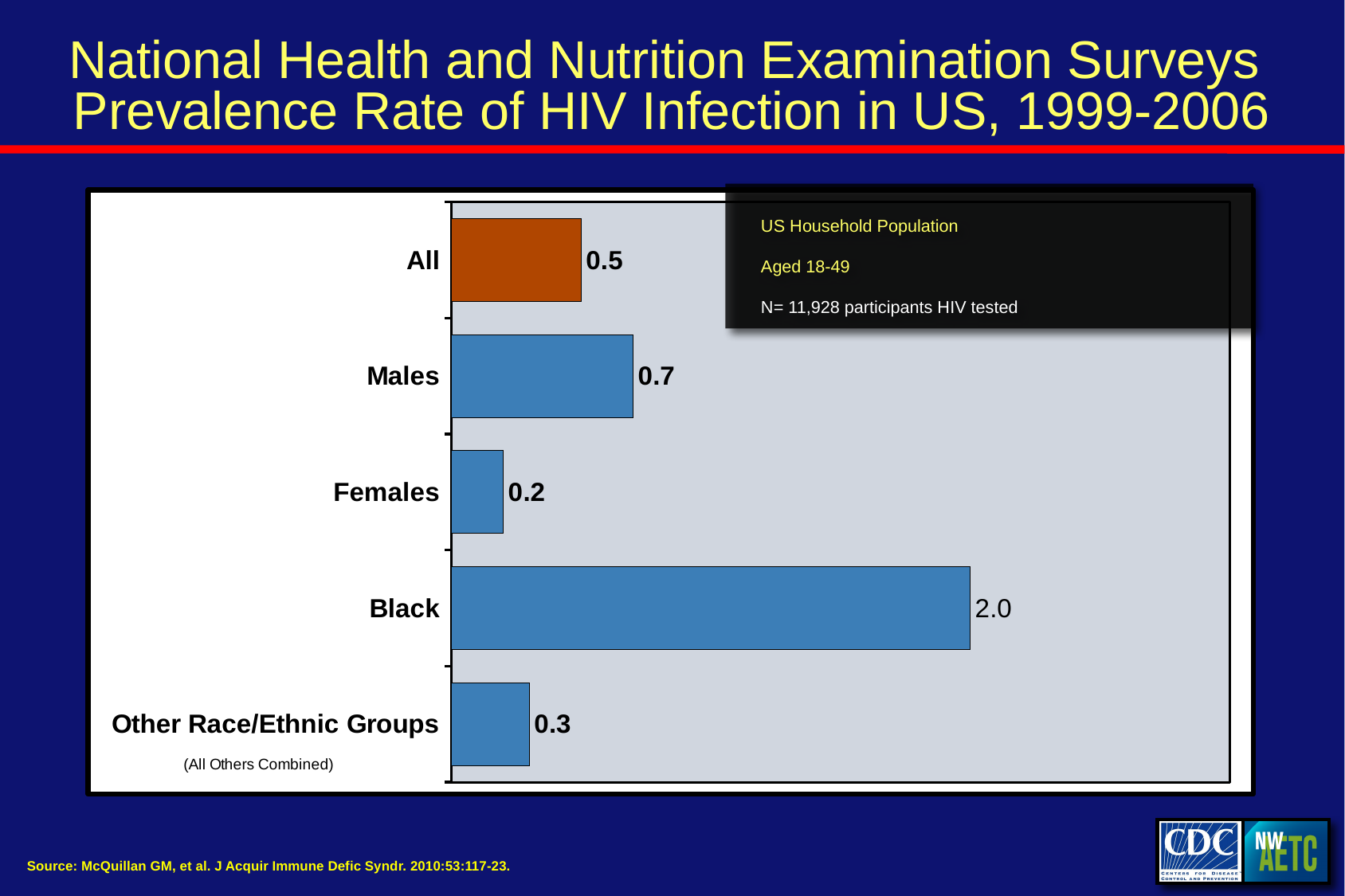
What is the HIV prevalence rate shown for Females? 0.2 Which category has the lowest prevalence rate? Females What is the HIV prevalence rate shown for Males? 0.7 Which is larger, the value for Males or the value for Other Race/Ethnic Groups? Males Which bar is coloured differently (orange) from the others? All What is the difference between the prevalence rates for Black and All? 1.5 What is the value shown for Other Race/Ethnic Groups? 0.3 Which category has the highest prevalence rate? Black What is the HIV prevalence rate shown for Black? 2.0 What is the difference between the prevalence rates for Males and Females? 0.5 How many categories are plotted in the chart? 5 What kind of chart is shown on the slide? Bar chart